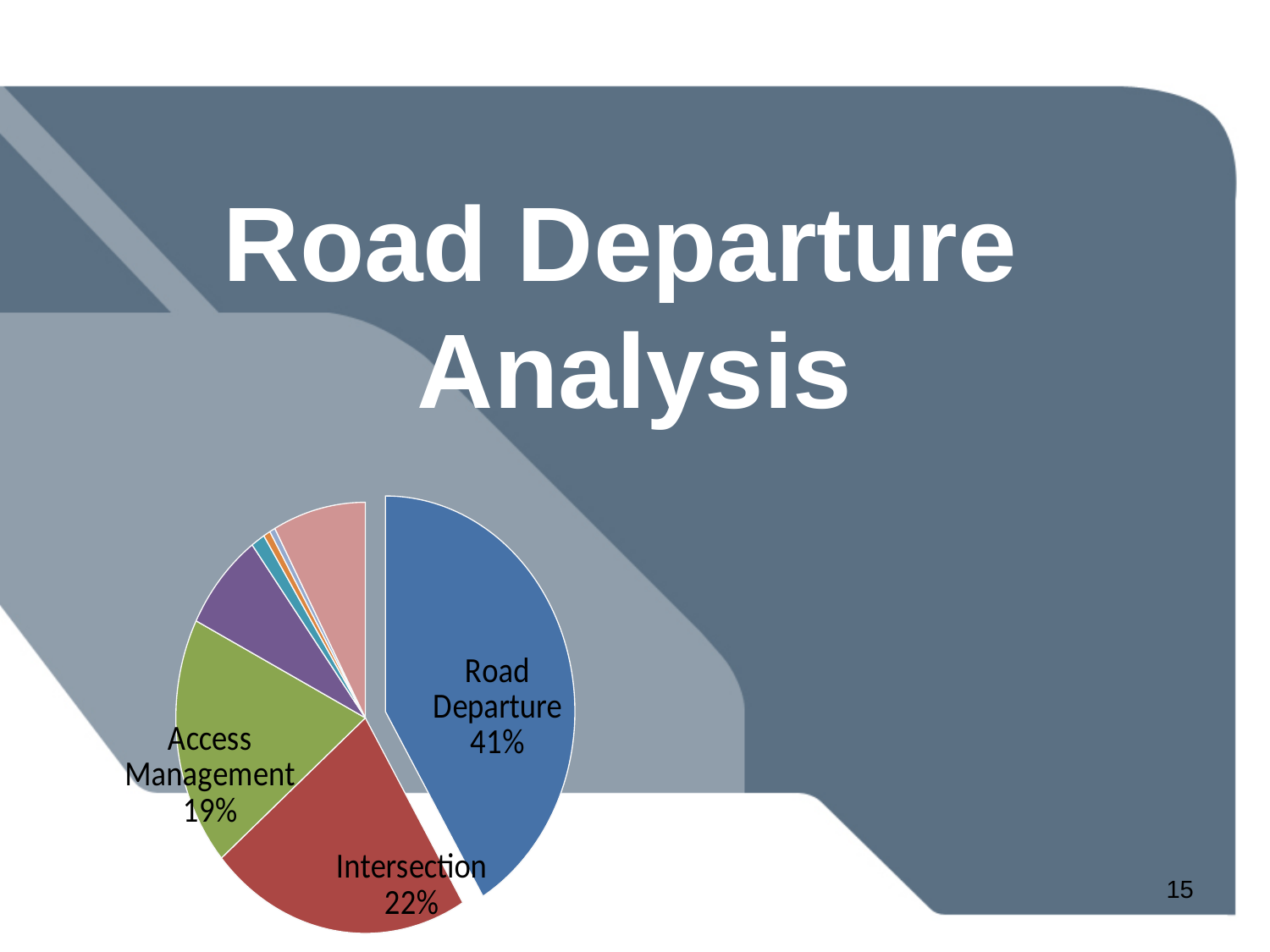
Which is larger in the pie chart, Intersection or Access Management? Intersection Which slice of the pie chart is pulled out from the rest? Road Departure What percentage of the pie chart is Road Departure? 41% What colour is the Road Departure slice? Blue Which labeled category has the largest share of the pie chart? Road Departure What percentage of the pie chart is Intersection? 22% Which is larger in the pie chart, Road Departure or Intersection? Road Departure What percentage of the pie chart is Access Management? 19% What kind of chart is shown on the slide? Pie chart How many percentage points larger is Intersection than Access Management? 3 What share of the pie does the Road Departure slice represent? 41% How many percentage points larger is Road Departure than Intersection? 19